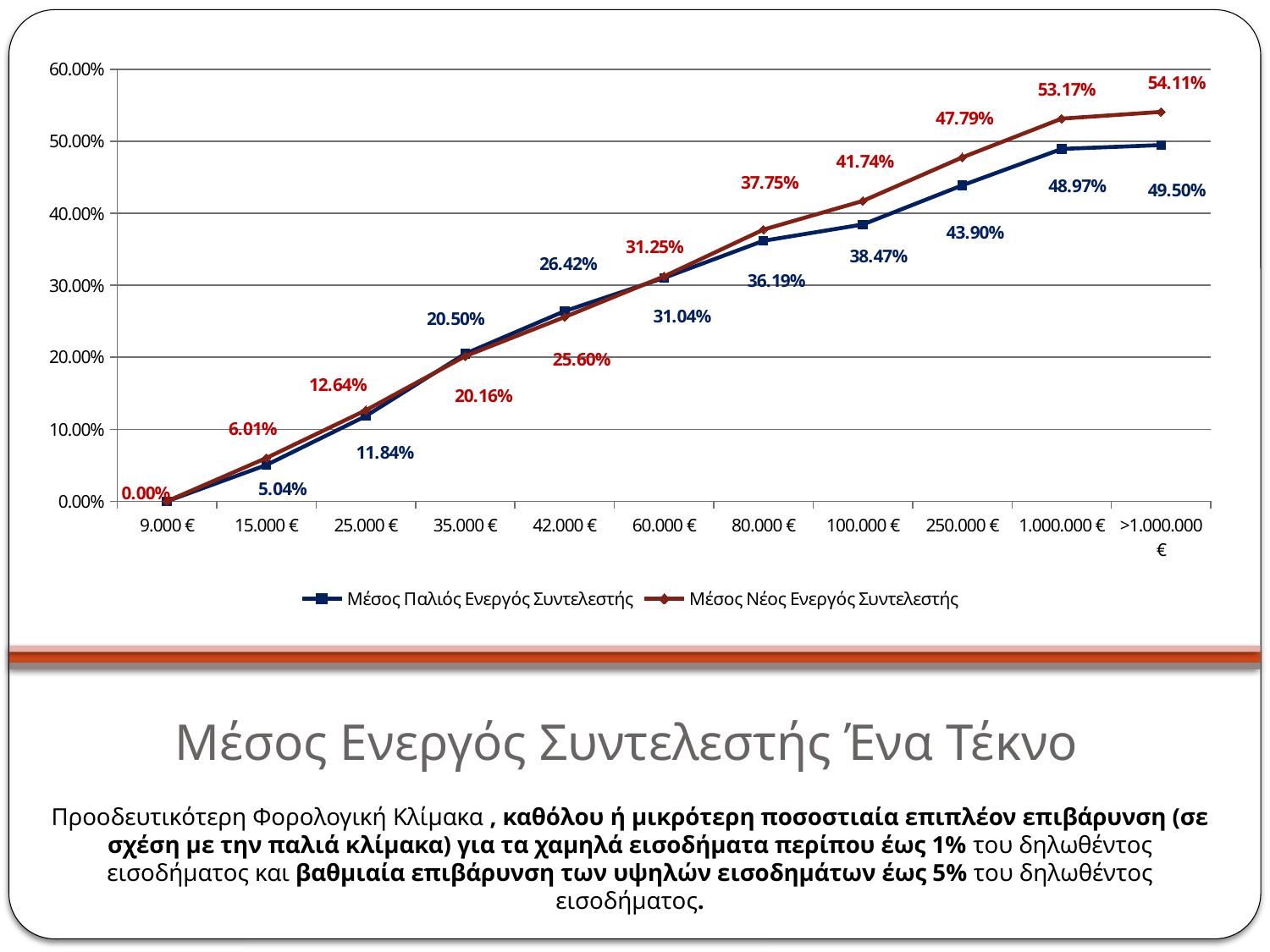
What colour is the line for Μέσος Παλιός Ενεργός Συντελεστής? blue What is the value of Μέσος Παλιός Ενεργός Συντελεστής at 250.000 €? 43.90% How many series does the legend list? 2 What type of chart is shown on the slide? line chart What is the difference between Μέσος Νέος Ενεργός Συντελεστής and Μέσος Παλιός Ενεργός Συντελεστής at 1.000.000 €? 4.20% At 35.000 €, which series has the larger value, Μέσος Παλιός Ενεργός Συντελεστής or Μέσος Νέος Ενεργός Συντελεστής? Μέσος Παλιός Ενεργός Συντελεστής Do the values of Μέσος Νέος Ενεργός Συντελεστής rise or fall as income increases along the x axis? rise How many income categories are shown on the x axis? 11 Is the value of Μέσος Νέος Ενεργός Συντελεστής at 80.000 € greater or less than 30.00%? greater At which income category is Μέσος Παλιός Ενεργός Συντελεστής highest? >1.000.000 € What is the value of Μέσος Νέος Ενεργός Συντελεστής at 100.000 €? 41.74% What is the value of Μέσος Νέος Ενεργός Συντελεστής at >1.000.000 €? 54.11%